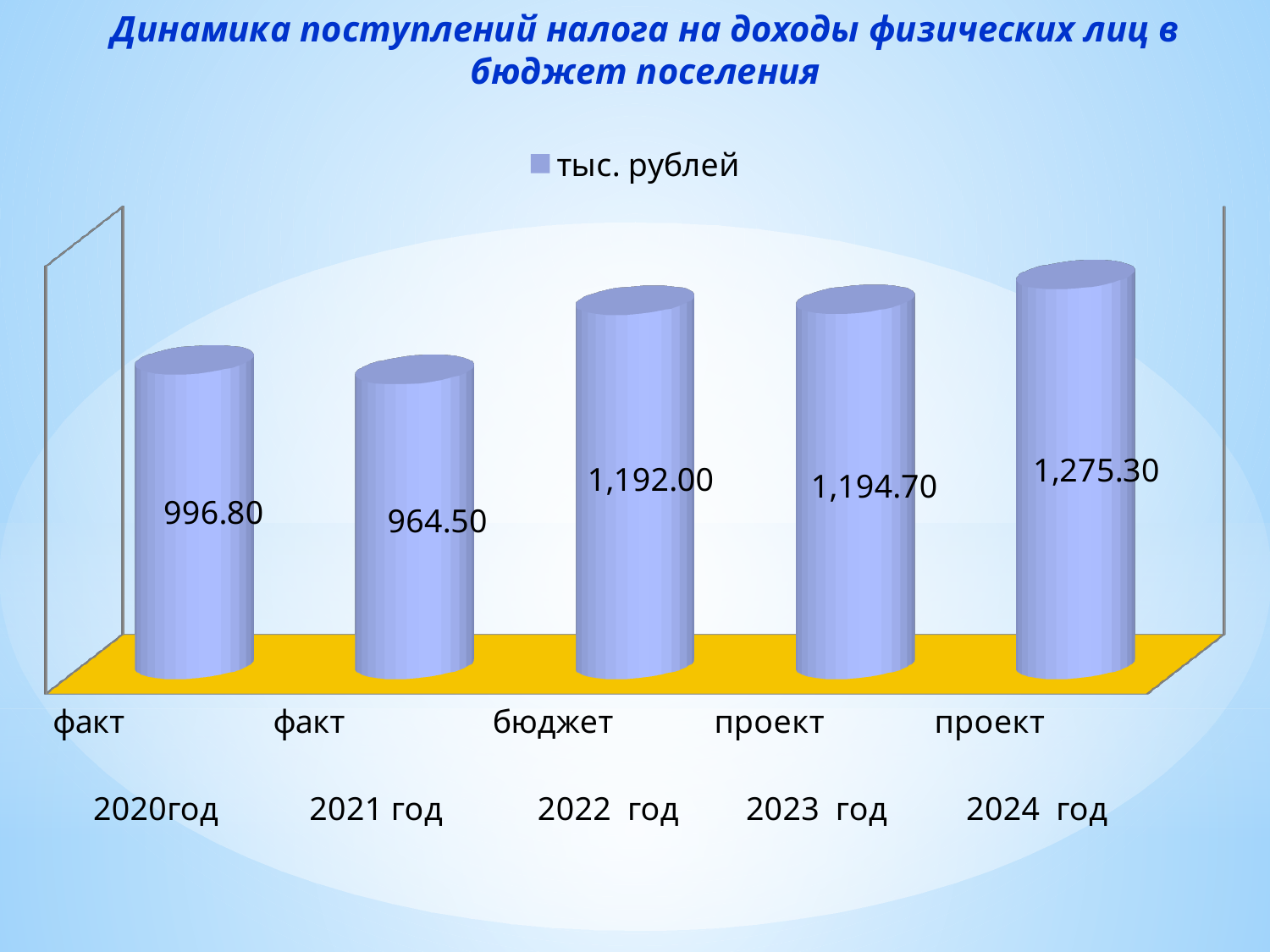
Which is larger, the value for 2022 год or the value for 2021 год? 2022 год What series name does the legend show? тыс. рублей What is the value for 2020 год (факт)? 996.80 What is the value for 2022 год (бюджет)? 1,192.00 What is the difference between the values for 2024 год and 2020 год? 278.50 What is the difference between the values for 2020 год and 2021 год? 32.30 Which year has the highest value? 2024 год Which year has the lowest value? 2021 год How many bars are shown in the chart? 5 What is the value for 2021 год (факт)? 964.50 What is the value for 2023 год (проект)? 1,194.70 What is the value for 2024 год (проект)? 1,275.30